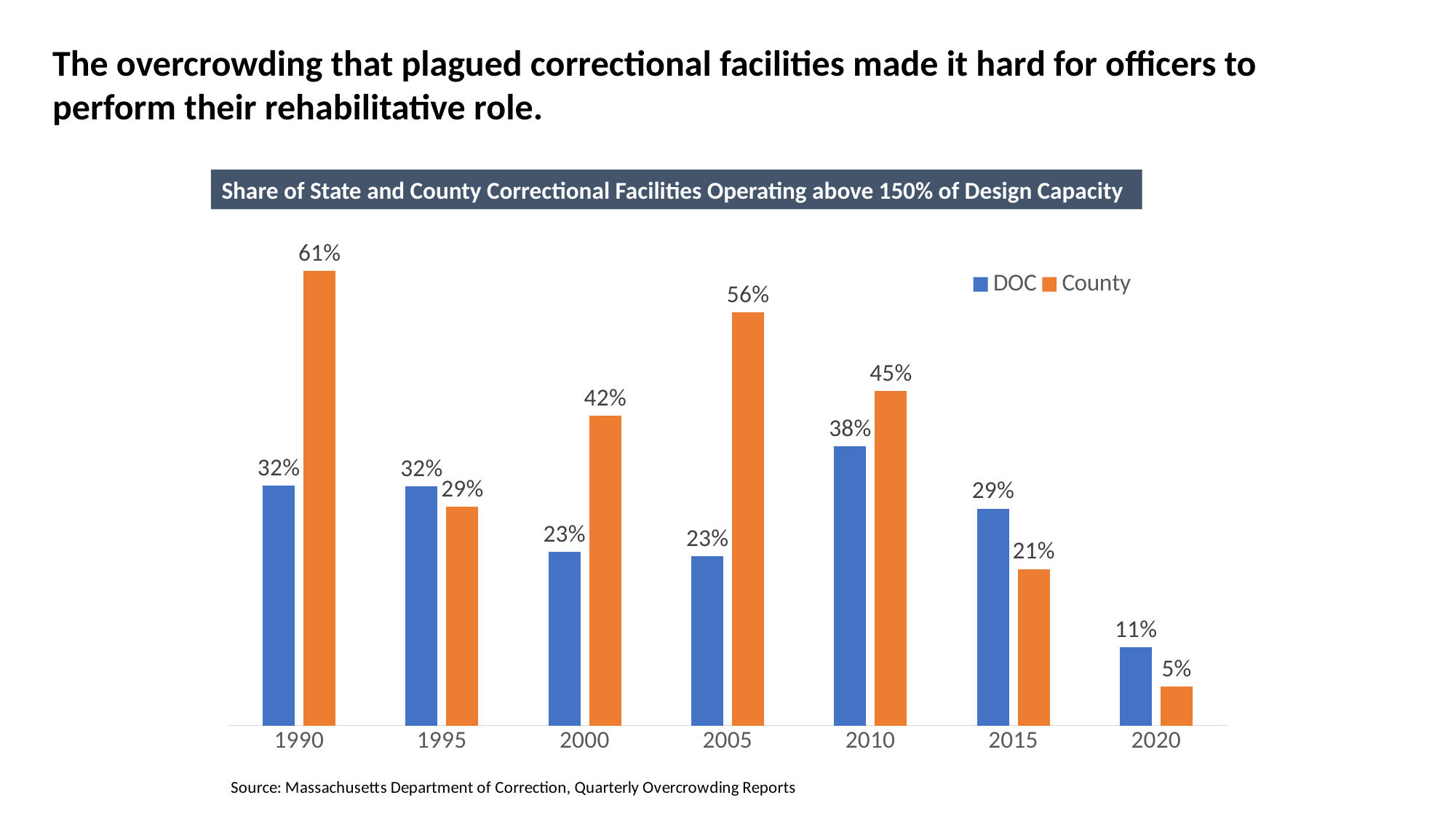
What is the title of the chart? Share of State and County Correctional Facilities Operating above 150% of Design Capacity How many series does the legend list? 2 Which year has the lowest DOC value? 2020 What is the County value for 2020? 5% Which year has the highest County value? 1990 How many years are shown on the x axis? 7 What is the County value for 1990? 61% What is the difference between the County and DOC values in 2005? 33% What kind of chart is shown on the slide? Bar chart Do the County values generally rise or fall from 2005 to 2020? Fall What is the DOC value for 2010? 38% Which is larger in 1995, the DOC value or the County value? DOC